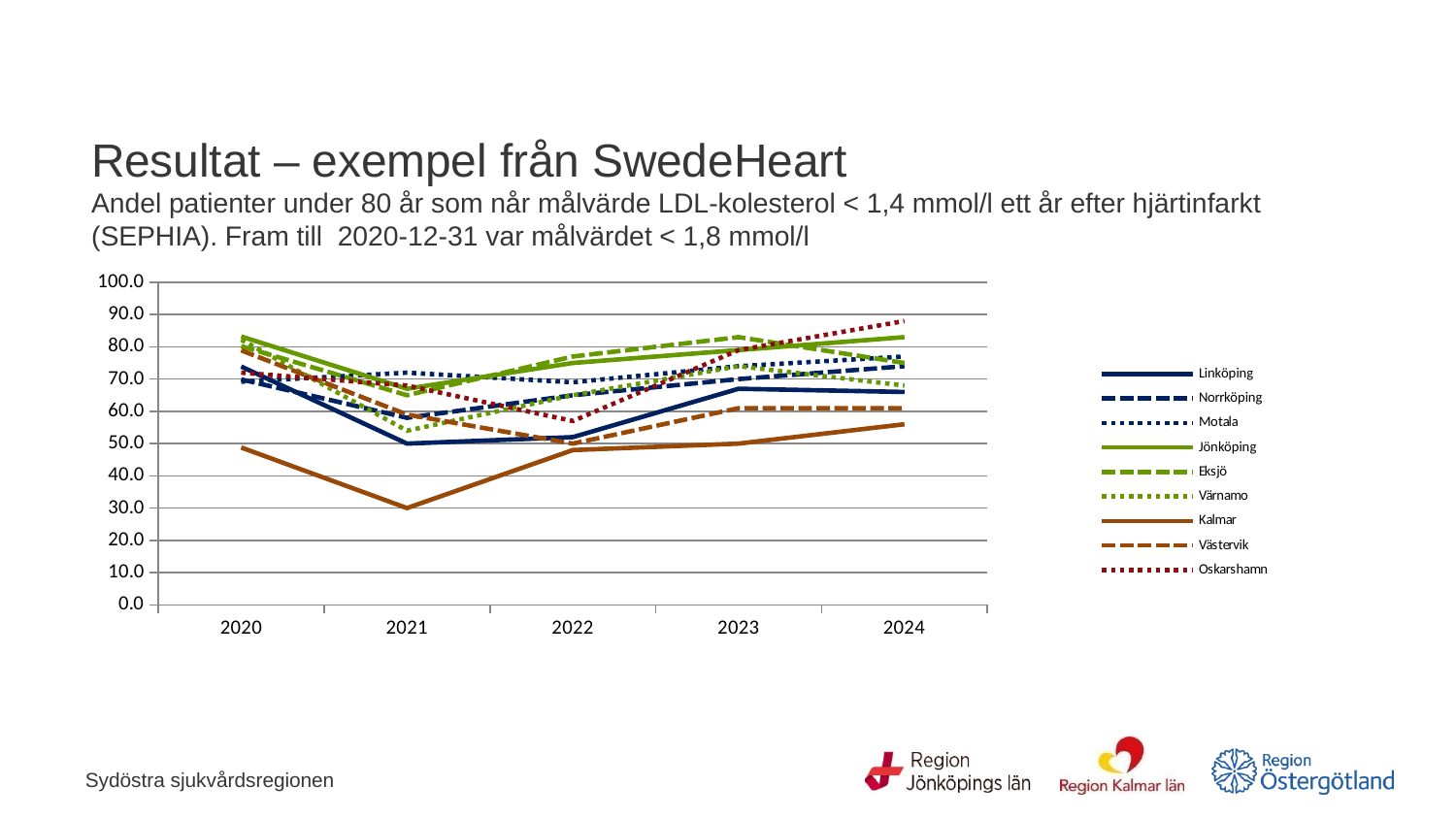
What kind of chart is shown on the slide? line chart How many years are shown on the x axis? 5 How many series does the legend list? 9 What is the highest value shown on the y axis? 100.0 Is the value for Linköping in 2021 greater or less than 60? less Which is larger in 2021, the value for Jönköping or the value for Kalmar? Jönköping Which series has the highest value in 2024? Oskarshamn Which series has the lowest value in 2020? Kalmar Does the value for Kalmar rise or fall from 2021 to 2024? rise Is the value for Oskarshamn in 2024 greater or less than 80? greater Is the value for Kalmar in 2021 greater or less than 40? less Which series has the lowest value in 2021? Kalmar